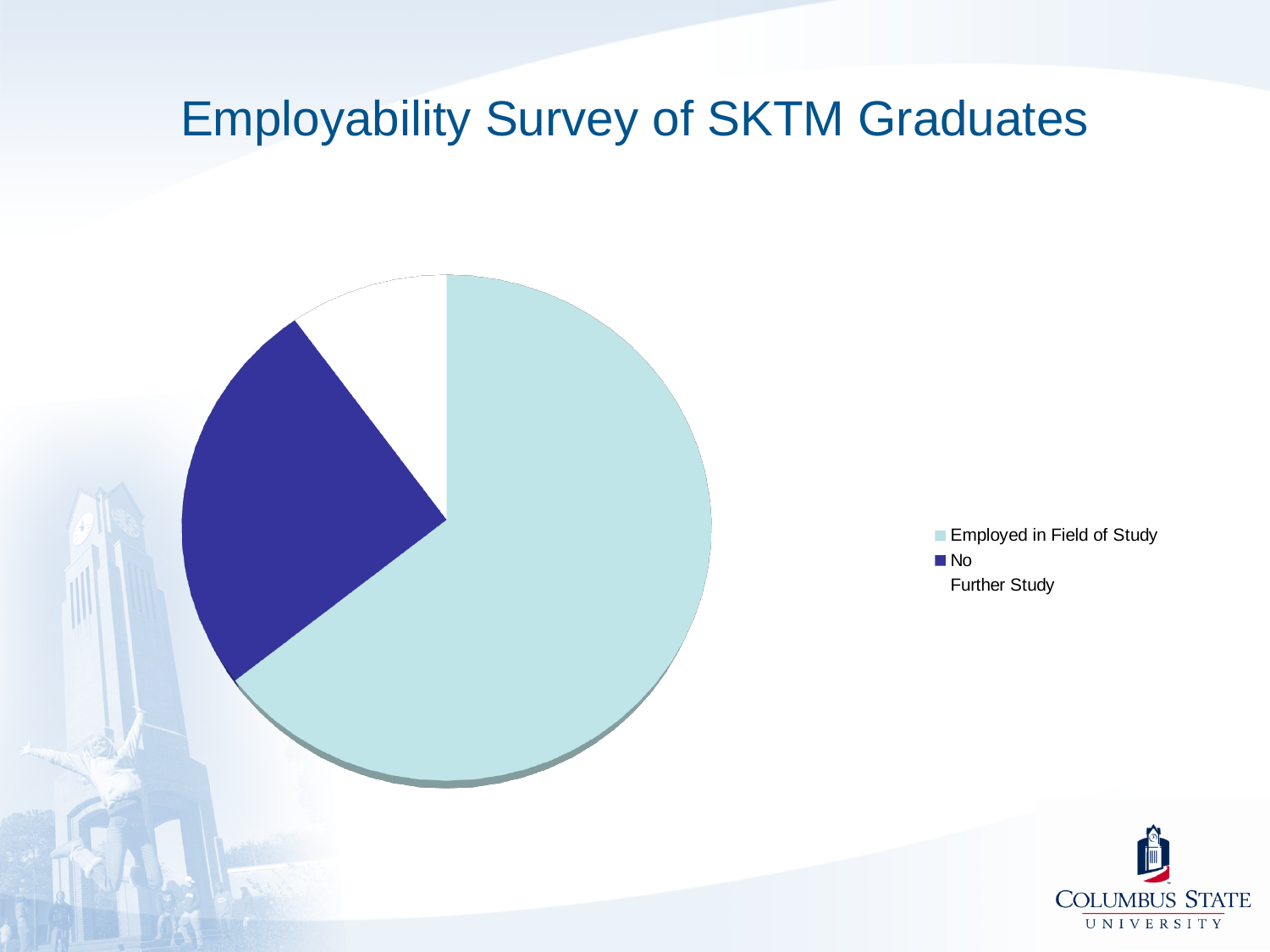
How many slices does the pie chart have? 3 What colour is the slice for "No" in the pie chart? Dark blue Which slice is larger, "Employed in Field of Study" or "No"? Employed in Field of Study What is the title of the slide containing the pie chart? Employability Survey of SKTM Graduates Which category has the smallest slice of the pie? Further Study What kind of chart is shown on the slide? Pie chart Which slice is larger, "No" or "Further Study"? No How many entries does the legend list? 3 Which category has the largest slice of the pie? Employed in Field of Study